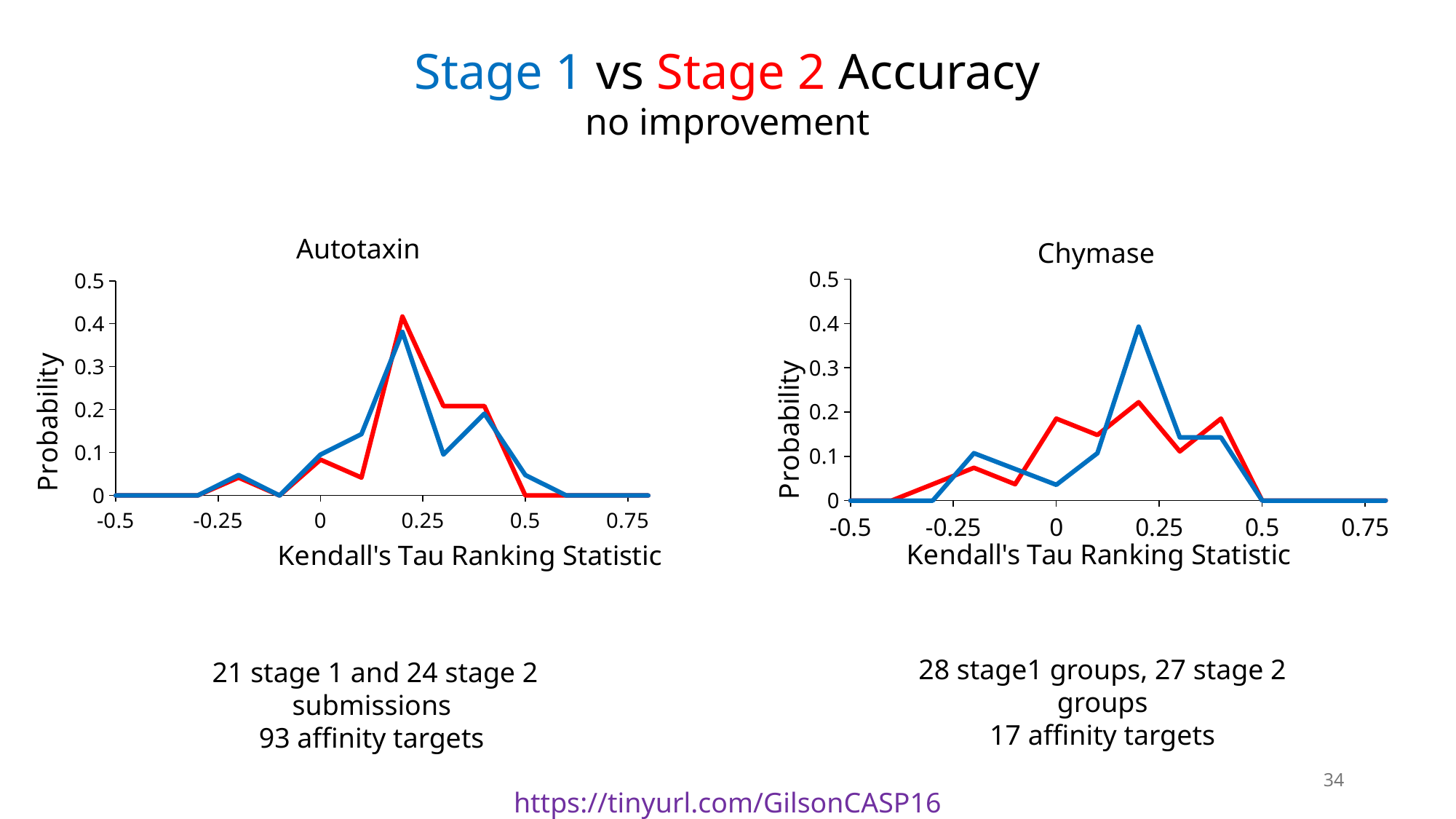
In the Autotaxin chart, which stage has the higher probability at a Kendall's Tau of 0.3? Stage 2 In the Chymase chart, is the Stage 2 (red) value at a Kendall's Tau of 0.2 greater or less than 0.3? less How many charts are shown on the slide? 2 In the Autotaxin chart, what is the Stage 2 (red) probability at a Kendall's Tau of 0.5? 0 In the Autotaxin chart, is the Stage 1 (blue) value at a Kendall's Tau of 0.2 greater or less than 0.4? less In the Autotaxin chart, is the Stage 2 (red) value at a Kendall's Tau of 0.2 greater or less than 0.4? greater In the Chymase chart, which stage has the higher probability at a Kendall's Tau of 0.2? Stage 1 What type of chart is the Autotaxin chart? line chart What is the x-axis label of the Autotaxin chart? Kendall's Tau Ranking Statistic What is the title of the chart on the right? Chymase